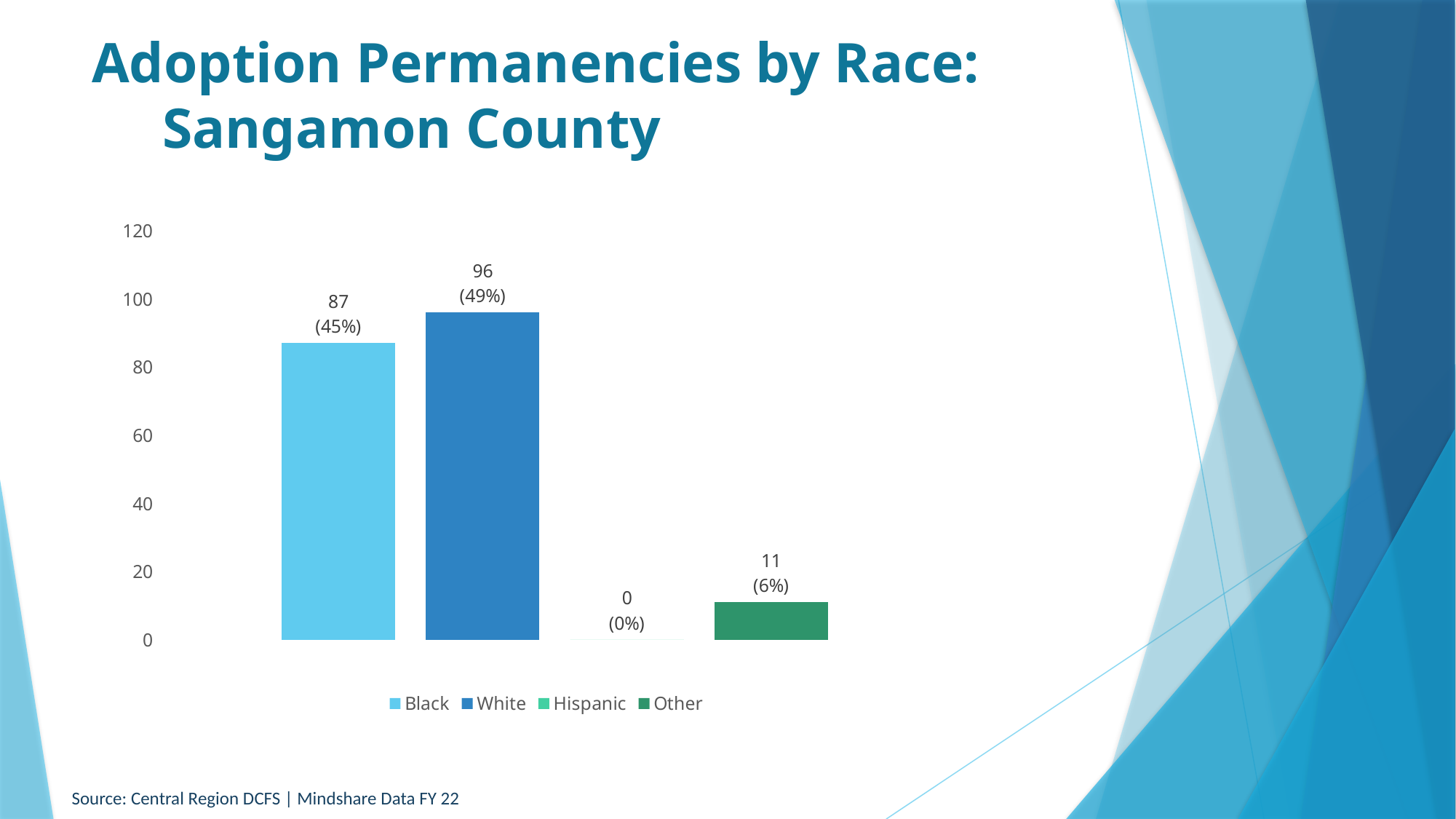
What kind of chart is shown on the slide? Bar chart What is the difference between the values for White and Black? 9 What is the value for Other? 11 What is the title of the slide? Adoption Permanencies by Race: Sangamon County How many series does the legend list? 4 What percentage is shown for Black? 45% What is the value for White? 96 Which category has the lowest value? Hispanic What is the value for Black? 87 Which category has the highest value? White Which is larger, the value for Black or the value for Other? Black What is the value for Hispanic? 0